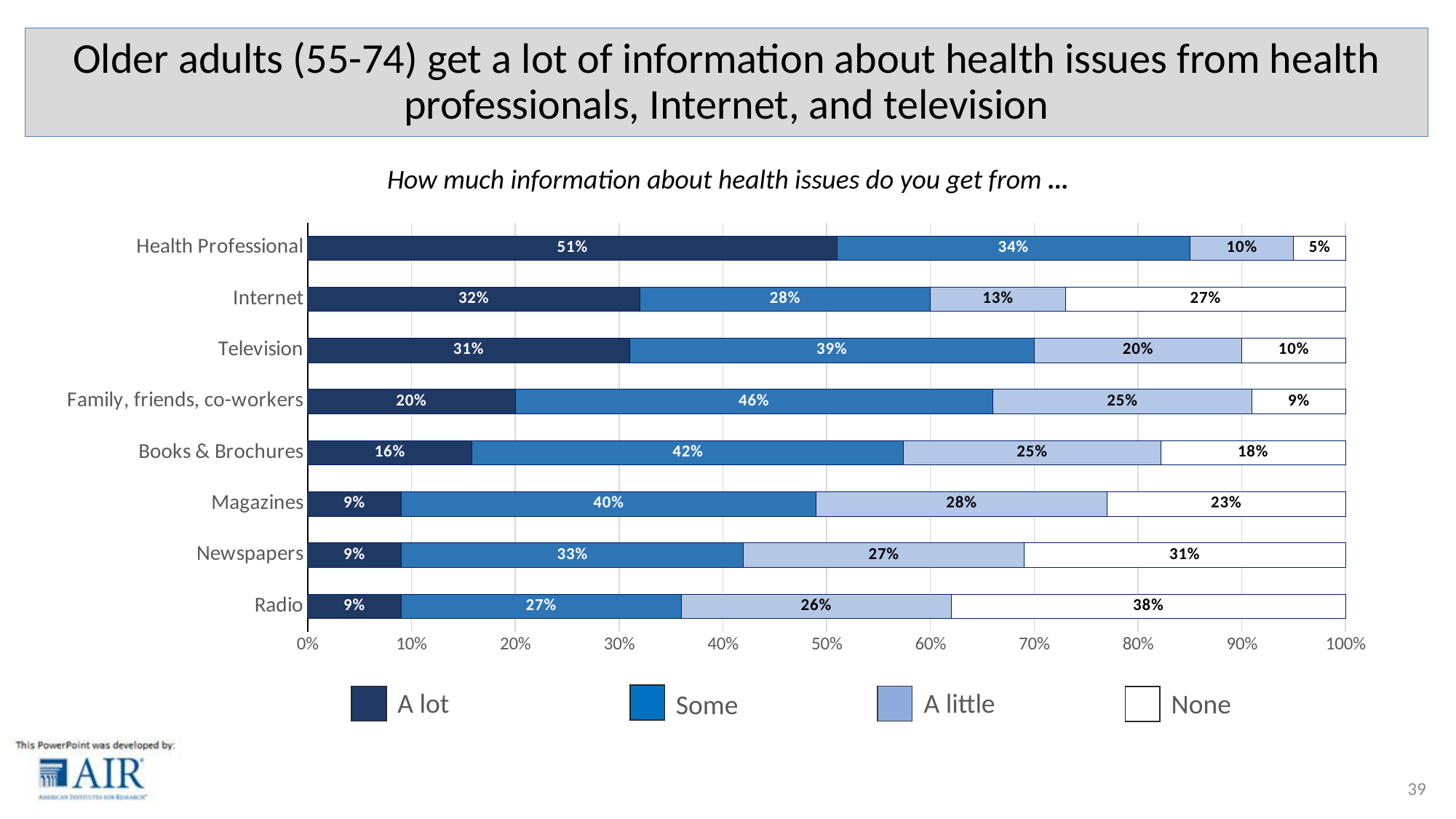
What is the total of the "A lot" and "Some" segments for Books & Brochures? 58% How many series does the legend list? 4 How many sources (categories) are shown on the chart? 8 Which source has the lowest "None" value? Health Professional What percentage of older adults say they get "A lot" of health information from Health Professionals? 51% What is the "A little" value for Internet? 13% What is the "None" value for Radio? 38% What is the "Some" value for Family, friends, co-workers? 46% Which source has the highest "A lot" value? Health Professional What kind of chart is shown on the slide? Stacked bar chart What is the difference between the "A lot" values for Internet and Television? 1% Which is larger, the "Some" value for Television or the "Some" value for Newspapers? Television